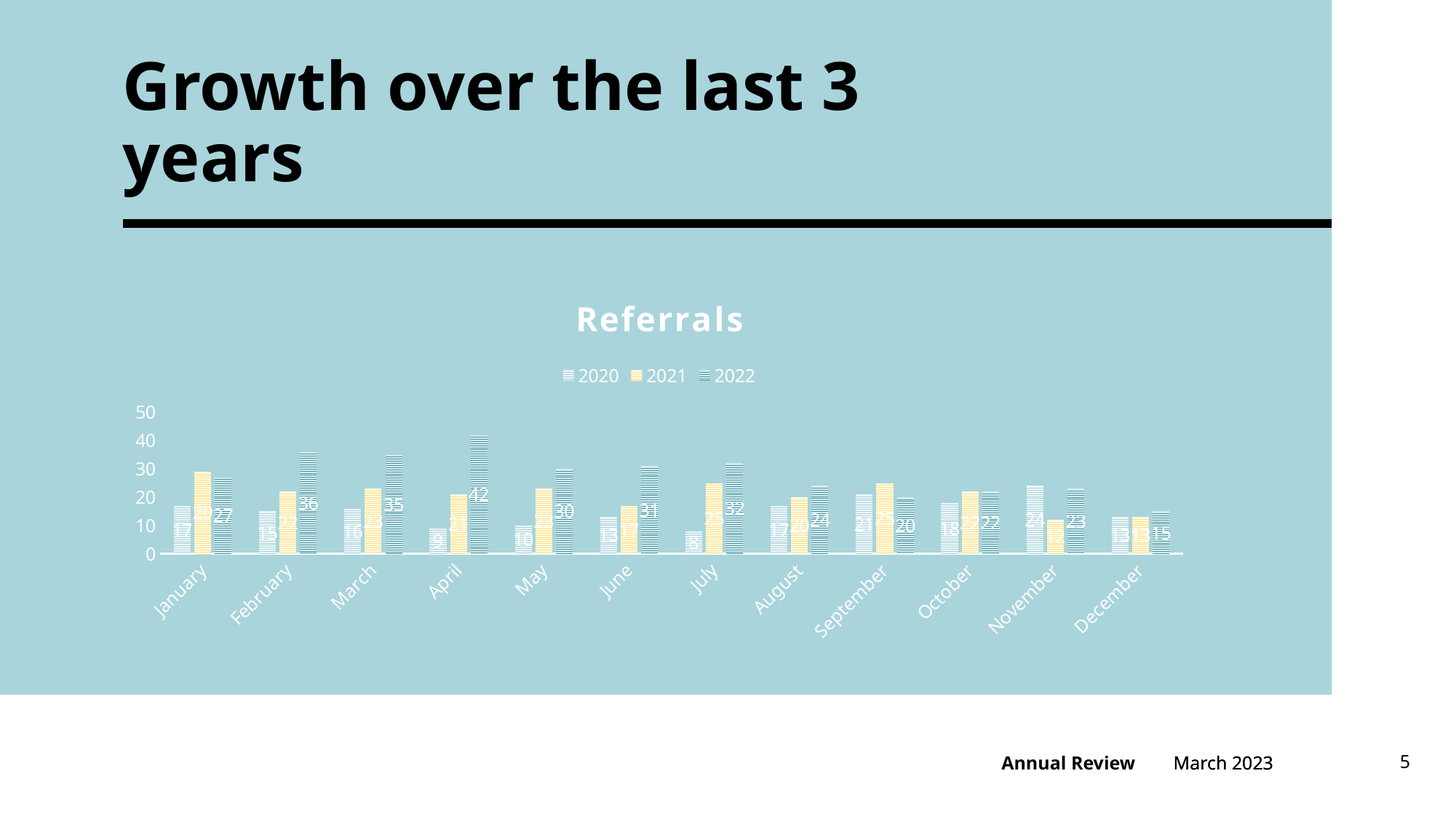
What is the title of the chart? Referrals In which month is the 2020 value lowest? July In which month is the 2022 value highest? April What is the difference between the 2022 and 2020 values in July? 24 What kind of chart is shown on the slide? bar chart How many series does the legend of the Referrals chart list? 3 What is the value for 2022 in April? 42 How many months are shown on the x axis of the Referrals chart? 12 In January, which is larger: the 2021 value or the 2022 value? 2021 What is the difference between the 2022 and 2020 values in February? 21 What is the value for 2021 in February? 22 What is the value for 2020 in November? 24